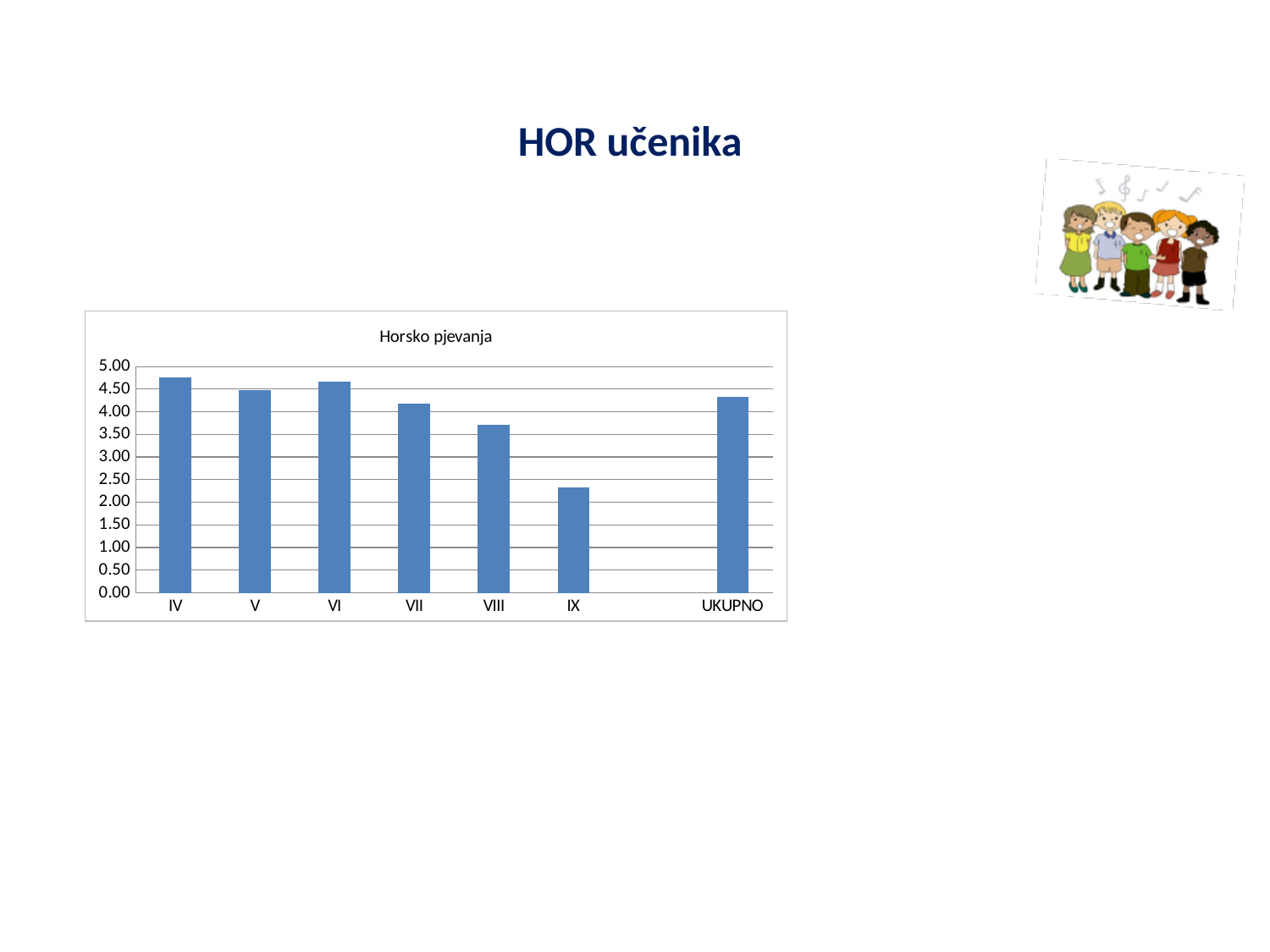
Which has the larger value, VII or VIII? VII Which category has the highest value in the chart? IV How many categories are shown on the x axis of the chart? 7 Which category has the lowest value in the chart? IX Is the value for IX greater or less than 2.50? less Is the value for UKUPNO greater or less than 4.00? greater Do the values rise or fall from IV to IX along the x axis? fall Is the value for IV greater or less than 4.50? greater What kind of chart is shown on the slide? bar chart Which has the larger value, IX or UKUPNO? UKUPNO What is the title of the chart? Horsko pjevanja